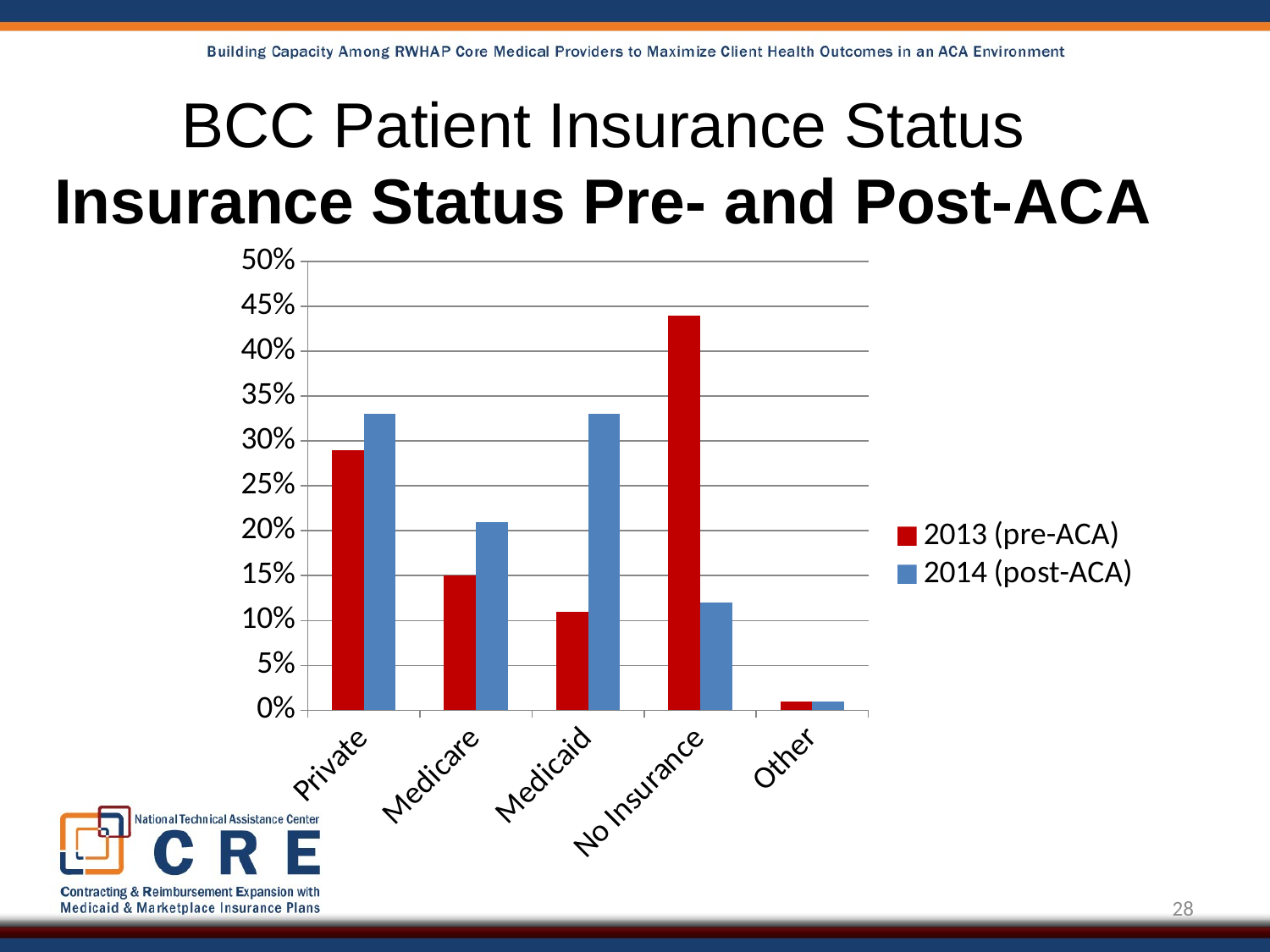
Is the 2013 (pre-ACA) value for Medicare greater or less than 20%? less What kind of chart is shown on the slide? Bar chart Which category has the lowest value for 2014 (post-ACA)? Other Is the 2014 (post-ACA) value for Medicaid greater or less than 30%? greater Which category has the highest value for 2013 (pre-ACA)? No Insurance How many insurance status categories are shown on the x axis? 5 For No Insurance, which is larger: the 2013 (pre-ACA) value or the 2014 (post-ACA) value? 2013 (pre-ACA) Is the 2014 (post-ACA) value for No Insurance greater or less than 15%? less What colour represents the 2013 (pre-ACA) series? Red How many series does the legend list? 2 For Medicaid, which is larger: the 2013 (pre-ACA) value or the 2014 (post-ACA) value? 2014 (post-ACA)